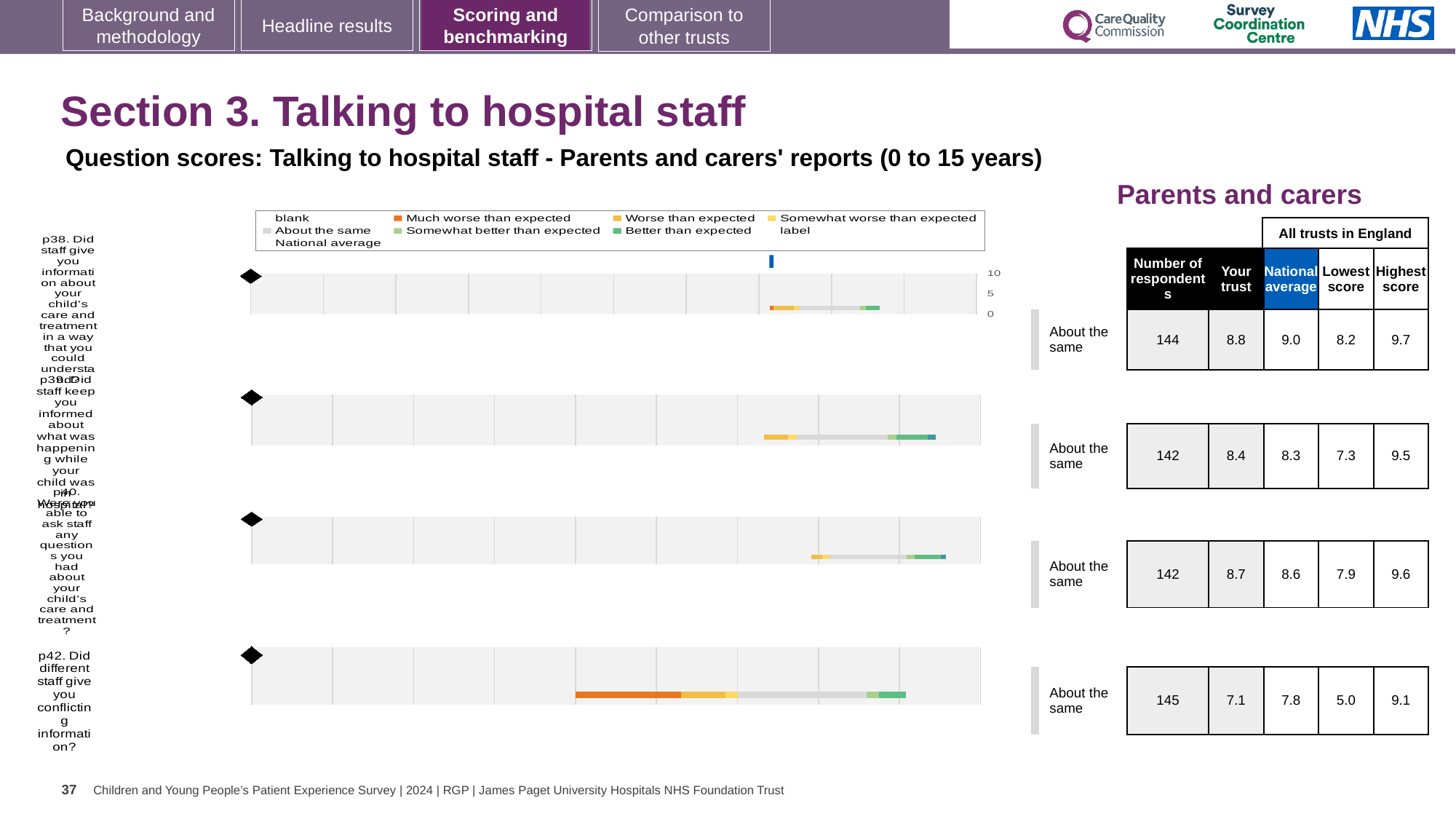
For question p42, what is the difference between the national average and the 'Your trust' score? 0.7 For question p42, what is the lowest score among all trusts in England? 5.0 For question p40 (being able to ask staff any questions), what is the highest score among all trusts in England? 9.6 In the chart legend, which colour represents 'Much worse than expected'? orange How many survey questions (chart rows) are plotted on the slide? 4 For question p39 (staff keeping you informed), which is larger: the 'Your trust' score or the national average? Your trust For question p38 (staff giving information about your child's care and treatment), what is the 'Your trust' score? 8.8 What kind of chart is used to show the question scores on this slide? bar chart Which question has the lowest 'Your trust' score? p42 Which question has the highest 'Your trust' score? p38 For question p42 (different staff giving conflicting information), how many respondents are there? 145 What benchmark category is shown for all four questions on this slide? About the same